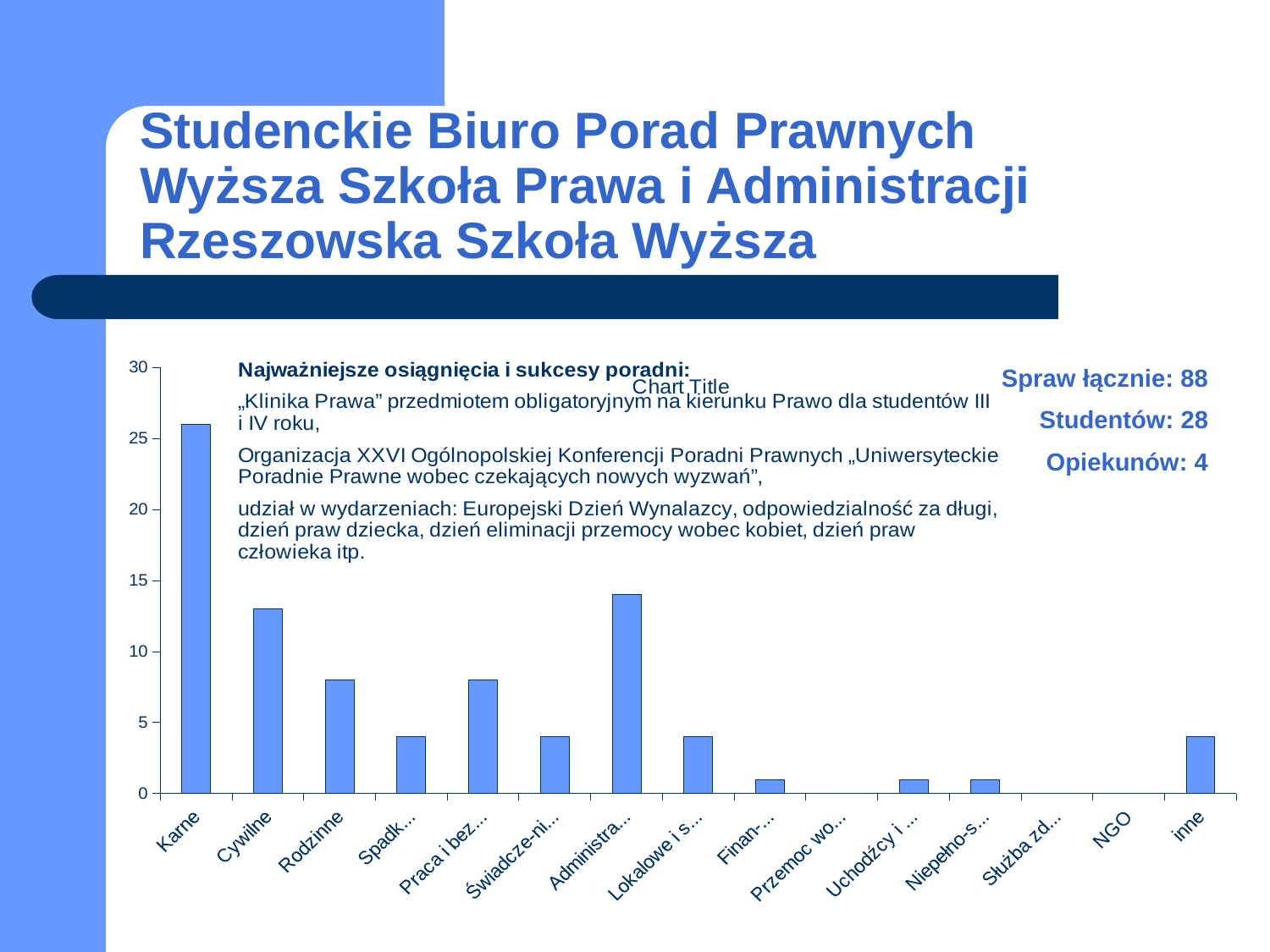
Which is larger, the value for Karne or the value for Administra...? Karne Is the value for Karne greater or less than 25? greater Which category has the highest bar in the chart? Karne Is the value for Rodzinne greater or less than 10? less Is the value for Cywilne greater or less than 10? greater What is the value for NGO in the chart? 0 How many categories are shown on the x axis of the chart? 15 What kind of chart is shown on the slide? bar chart What is the title shown above the chart? Chart Title Which is larger, the value for Rodzinne or the value for Spadk...? Rodzinne